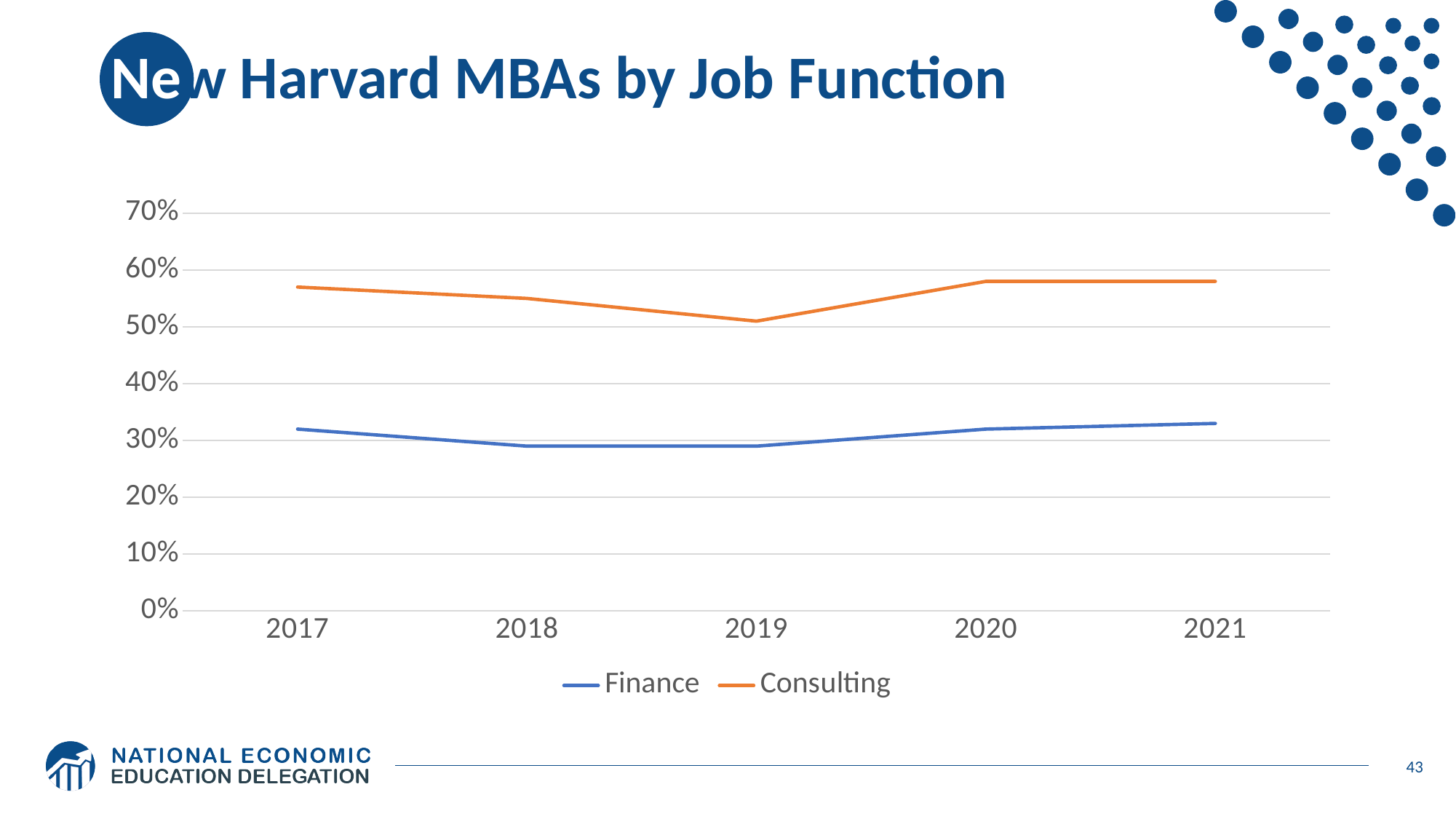
How many series does the legend list? 2 Is the Finance value for 2019 greater or less than 40%? less Is the Consulting value for 2017 greater or less than 50%? greater Does the Finance line rise or fall from 2019 to 2021? rise Is the Consulting value for 2020 greater or less than 60%? less What kind of chart is shown on the slide? line chart In which year is the Consulting value lowest? 2019 What colour is the Consulting line? orange Does the Consulting line rise or fall from 2017 to 2019? fall How many years are shown on the x axis? 5 Which series has the higher value in 2019, Finance or Consulting? Consulting